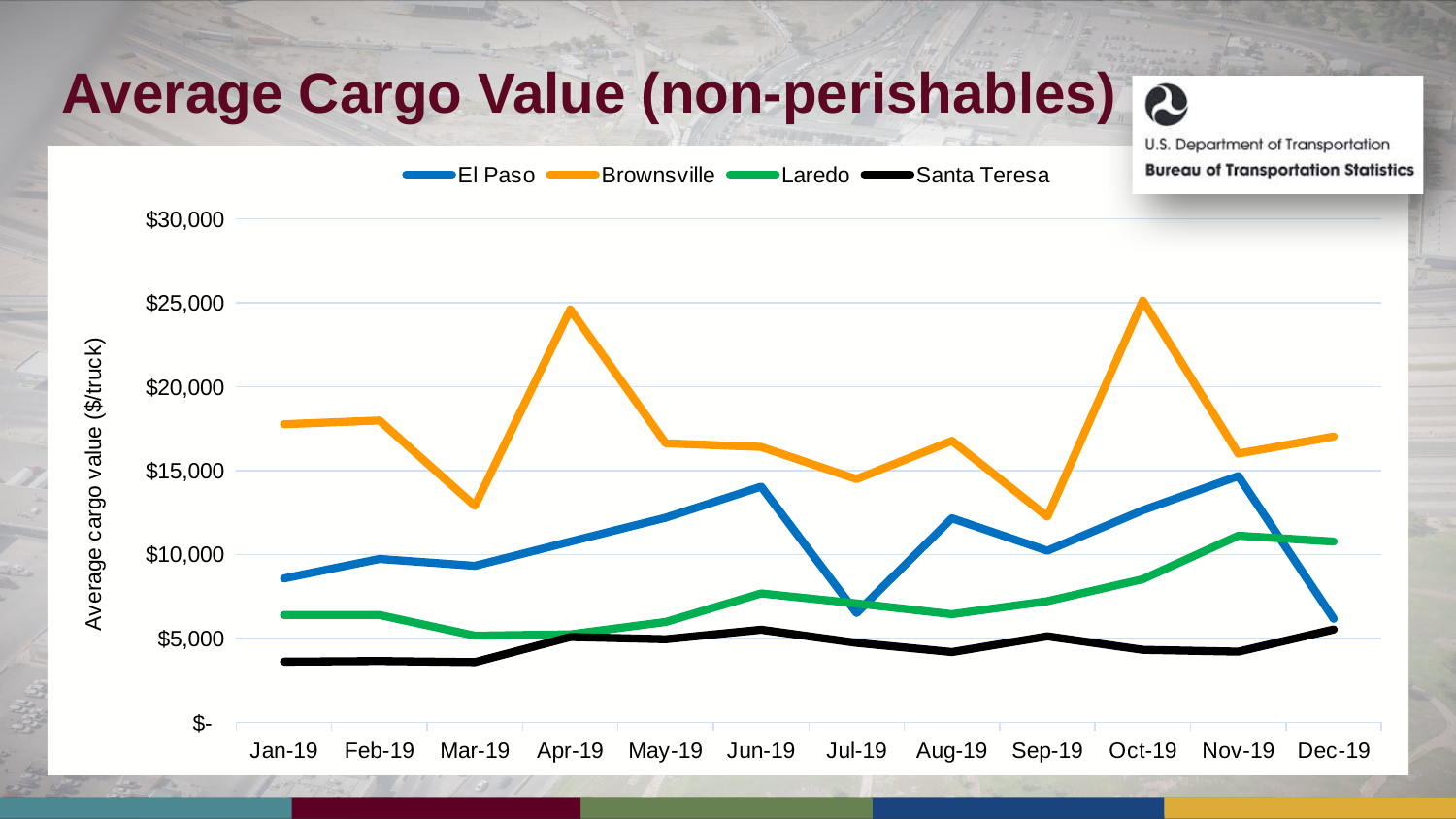
Which series has the highest value in Oct-19? Brownsville Is the value for El Paso in Dec-19 greater or less than $10,000? less What kind of chart is shown on the slide? line chart Does the El Paso line rise or fall from Nov-19 to Dec-19? fall How many series does the legend list? 4 What is the label on the y axis? Average cargo value ($/truck) Is the value for Laredo in Nov-19 greater or less than $10,000? greater Is the value for Brownsville in Apr-19 greater or less than $20,000? greater In Jun-19, which is larger: the value for El Paso or the value for Laredo? El Paso Which series has the lowest value in Jan-19? Santa Teresa How many months are shown along the x axis? 12